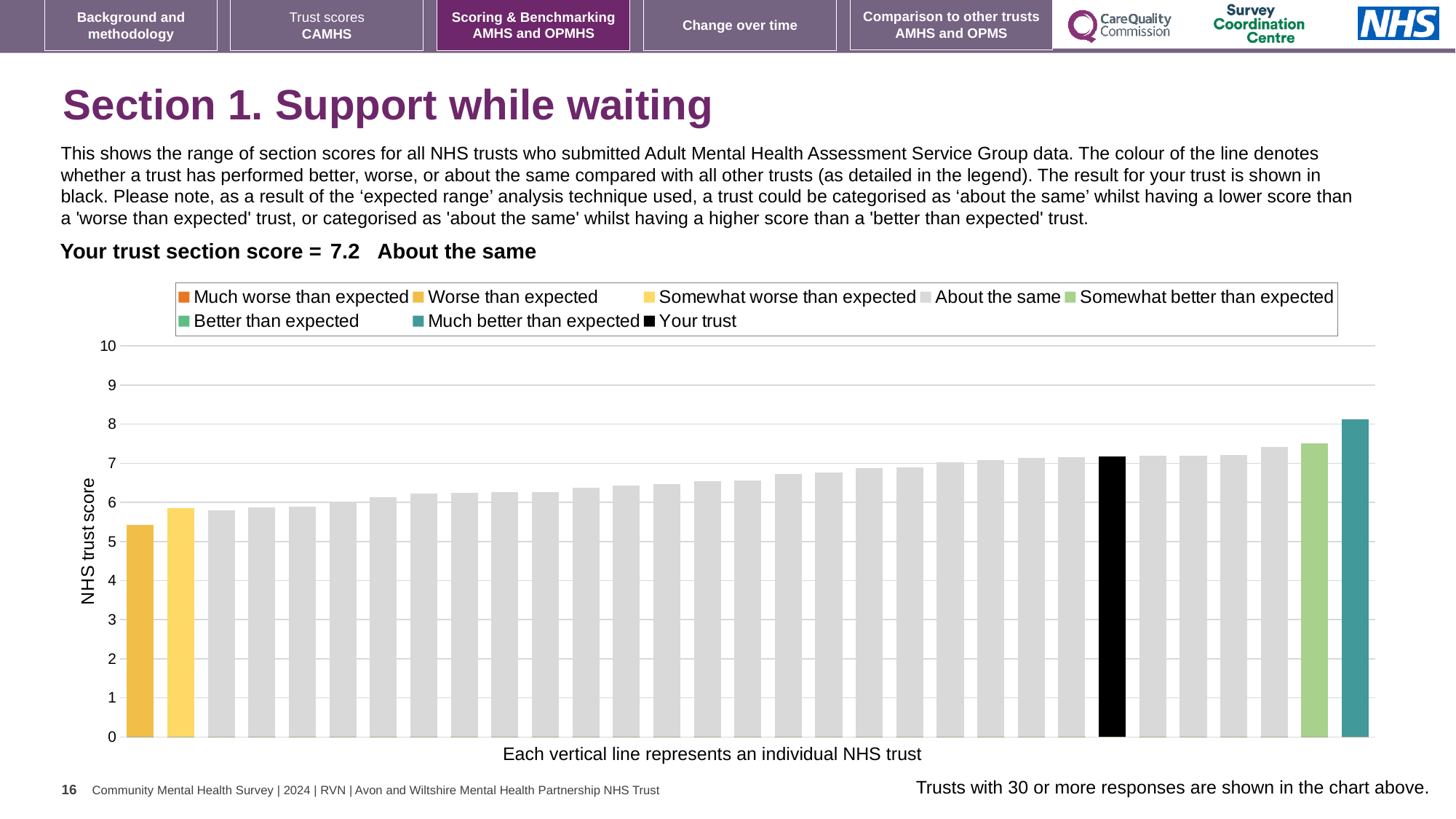
Is the value for the rightmost bar greater or less than 7? greater What is your trust's section score for Support while waiting? 7.2 What is the label on the vertical axis of the chart? NHS trust score How many entries does the chart legend list? 8 Is the value for the leftmost bar greater or less than 6? less Is the bar for your trust higher or lower than the leftmost bar? higher Is the value for your trust (the black bar) greater or less than 7? greater Do the bar values rise or fall from left to right along the x axis? rise What colour is used for the bar representing your trust? black Which legend category does the highest bar belong to? Much better than expected Which benchmarking category is your trust placed in for this section? About the same What kind of chart is shown on the slide? bar chart